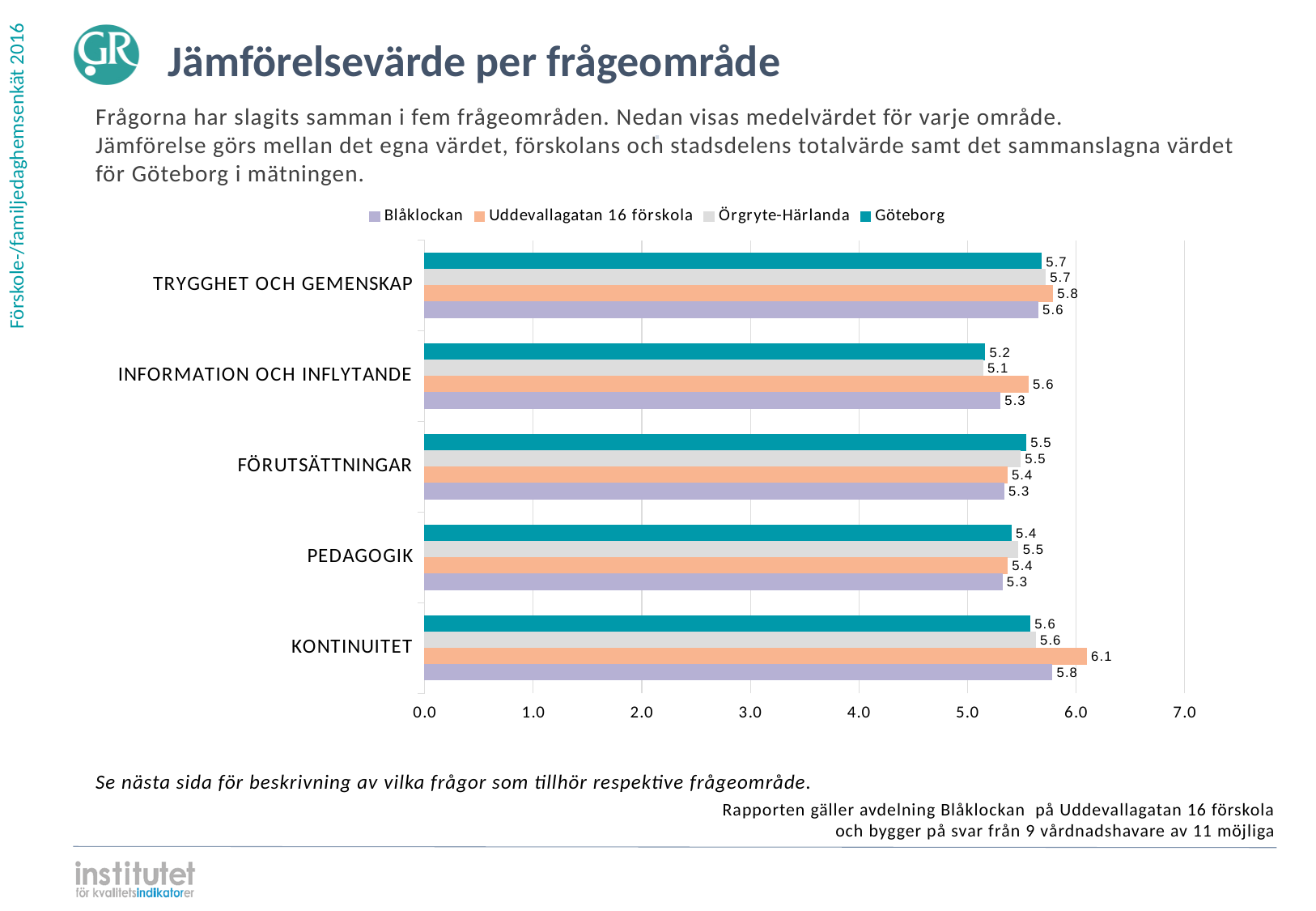
What is the value for Göteborg in the PEDAGOGIK category? 5.4 What kind of chart is shown on the slide? Bar chart What is the value for Blåklockan in the KONTINUITET category? 5.8 How many series does the legend list? 4 How many categories are shown on the chart? 5 In which category does Uddevallagatan 16 förskola have its highest value? KONTINUITET In the INFORMATION OCH INFLYTANDE category, which is larger: the value for Uddevallagatan 16 förskola or the value for Örgryte-Härlanda? Uddevallagatan 16 förskola In which category does Blåklockan have its lowest value? INFORMATION OCH INFLYTANDE, FÖRUTSÄTTNINGAR and PEDAGOGIK (tied at 5.3) Which series is shown in teal on the chart? Göteborg What is the difference between the Uddevallagatan 16 förskola value and the Blåklockan value in the KONTINUITET category? 0.3 What is the value for Uddevallagatan 16 förskola in the INFORMATION OCH INFLYTANDE category? 5.6 What is the value for Örgryte-Härlanda in the TRYGGHET OCH GEMENSKAP category? 5.7